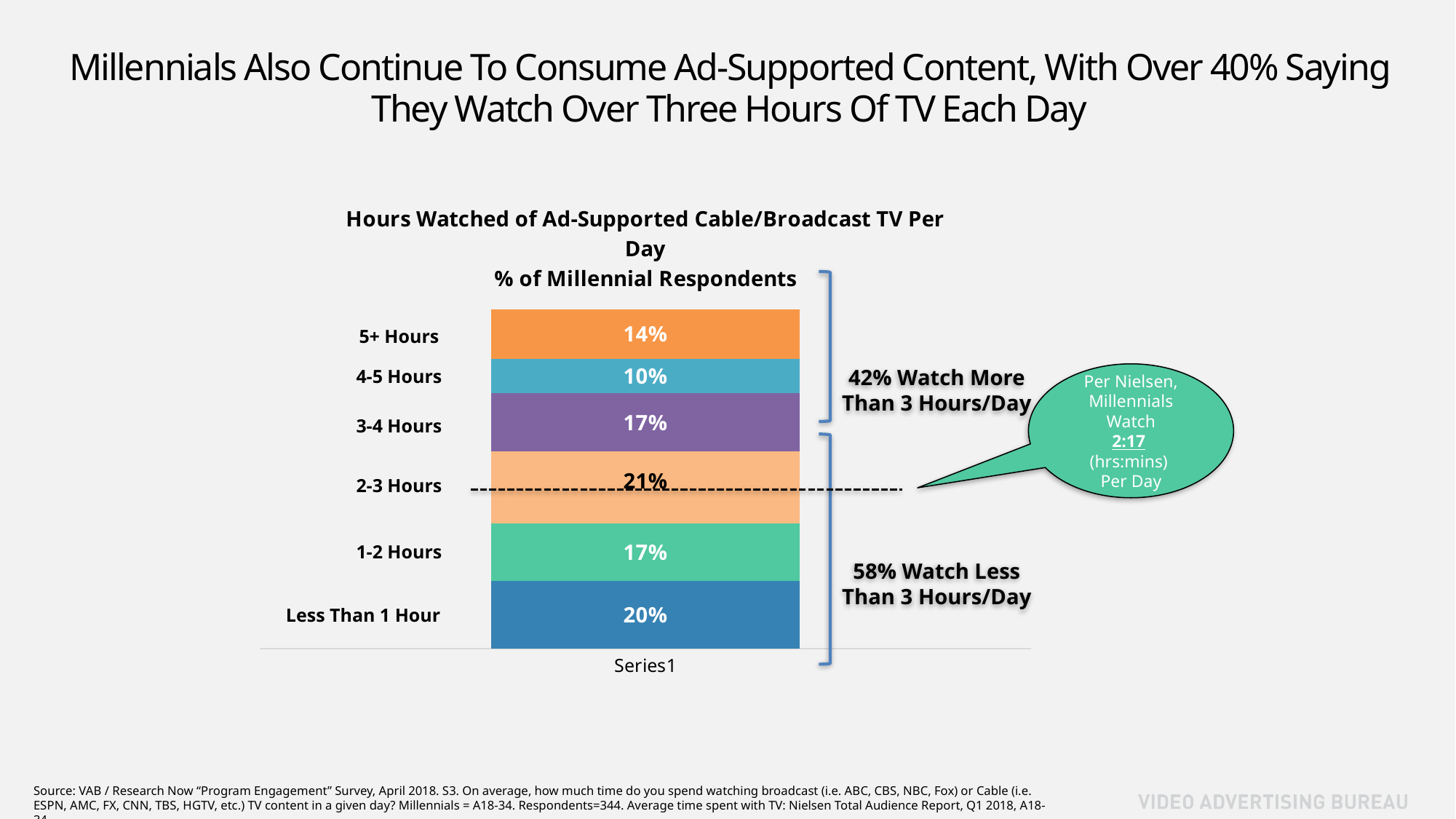
Which is larger: the share watching less than 1 hour or the share watching 5+ hours? Less Than 1 Hour Which hours-watched category has the largest share of respondents? 2-3 Hours What percentage of Millennial respondents watch 5+ hours of ad-supported TV per day? 14% What is the difference between the share watching 2-3 hours and the share watching 4-5 hours? 11% What kind of chart is shown on the slide? Stacked bar chart According to the slide, what percentage of Millennials watch more than 3 hours per day? 42% What percentage of Millennial respondents watch 4-5 hours per day? 10% Which hours-watched category has the smallest share of respondents? 4-5 Hours How many hours-watched categories are shown in the stacked bar? 6 What percentage of Millennial respondents watch 2-3 hours per day? 21% What is the title of the chart? Hours Watched of Ad-Supported Cable/Broadcast TV Per Day % of Millennial Respondents What percentage of Millennial respondents watch less than 1 hour per day? 20%